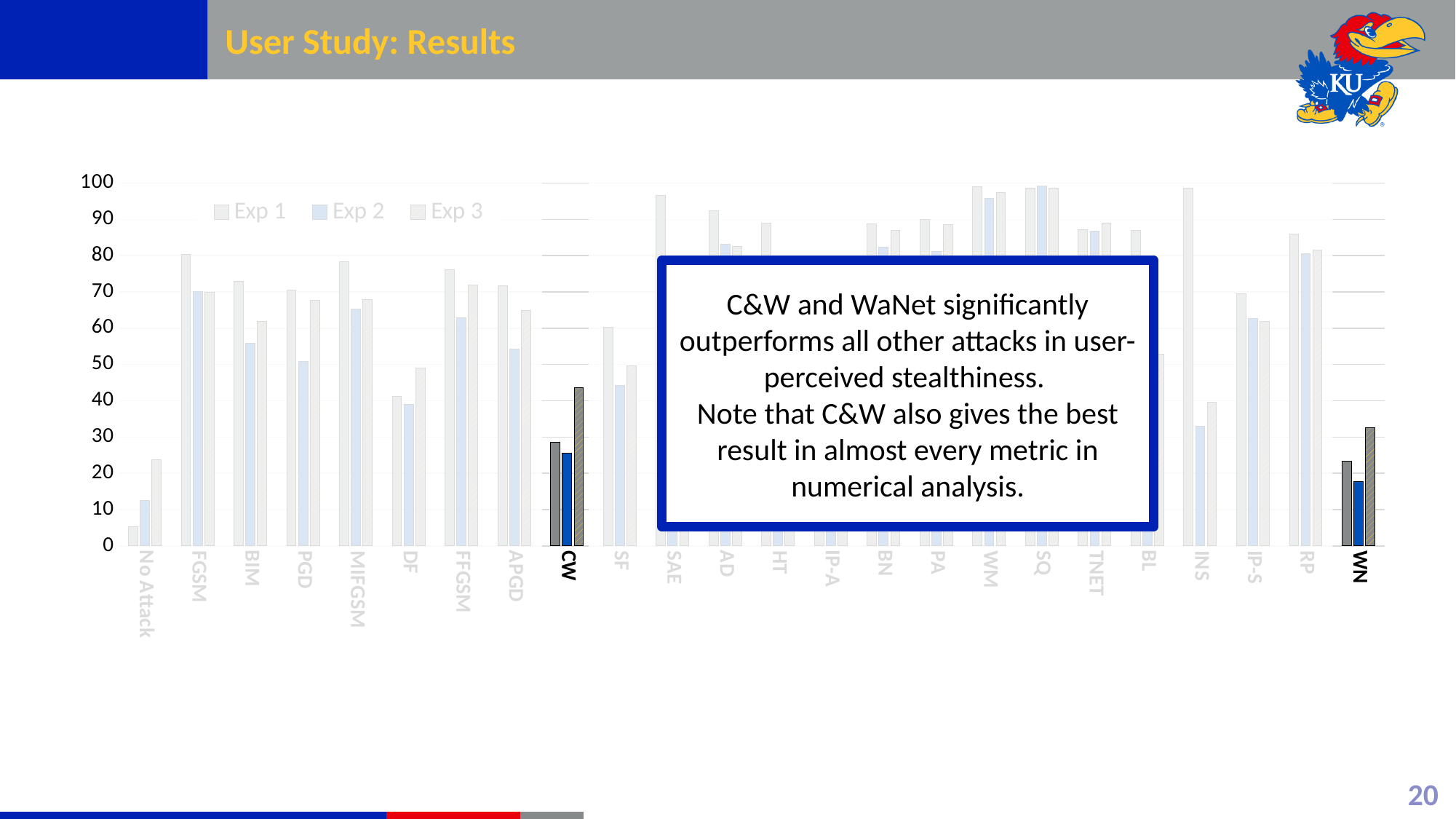
How many attack categories are shown along the x axis of the chart? 24 Is the Exp 1 value for WN greater or less than 30? less What kind of chart is shown on the slide? bar chart Is the Exp 1 value for FGSM greater or less than 70? greater What are the series names listed in the chart legend? Exp 1, Exp 2, Exp 3 How many series does the chart legend list? 3 Is the Exp 1 value for No Attack greater or less than 10? less Which category has the lowest Exp 1 value? No Attack Which has the larger Exp 1 value, CW or FGSM? FGSM Which two categories on the x axis are highlighted with dark-coloured bars? CW and WN